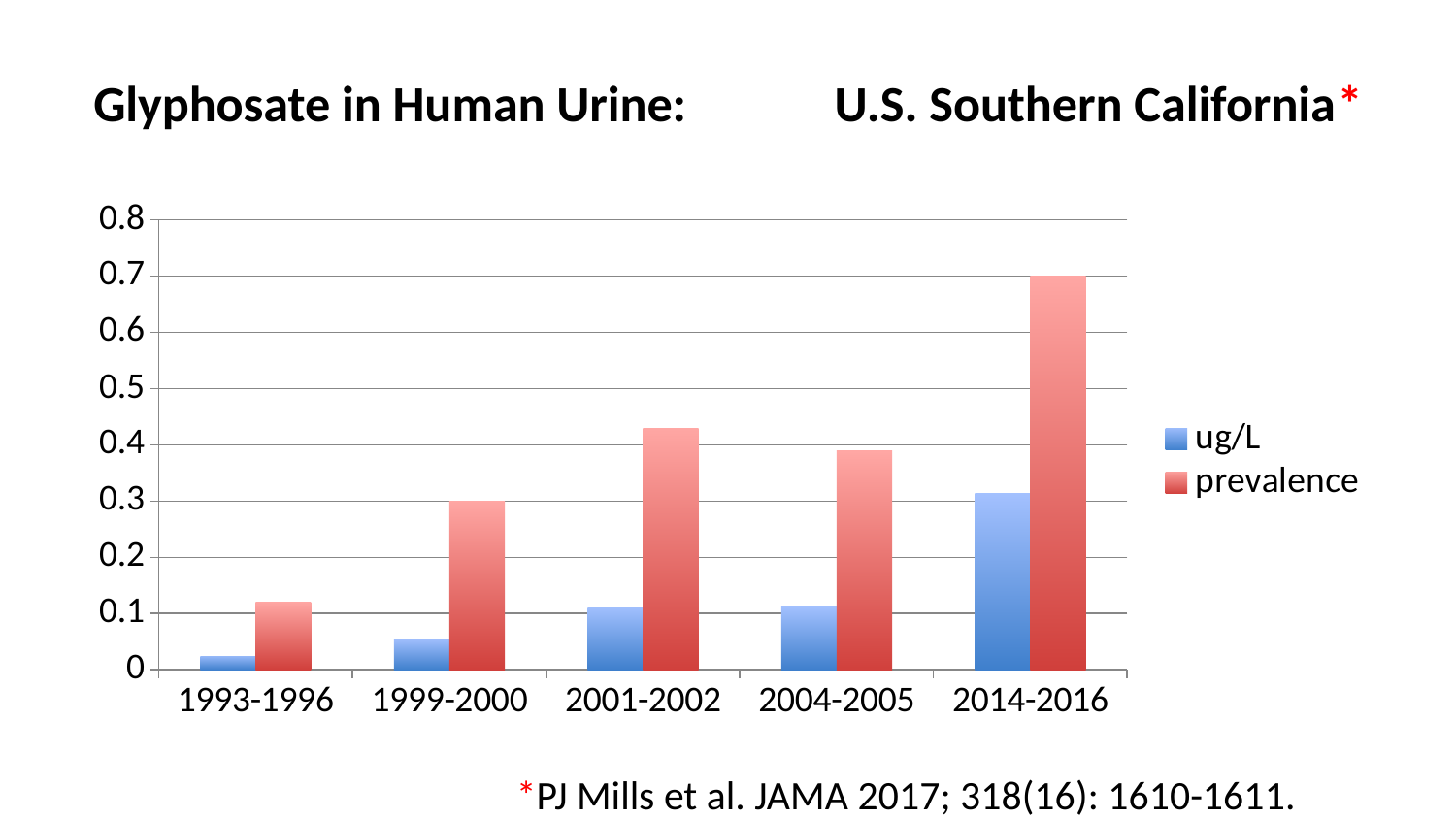
Is the ug/L value for 2014-2016 greater or less than 0.4? less What is the prevalence value for 2014-2016? 0.7 Which is larger: the prevalence value for 1993-1996 or the prevalence value for 1999-2000? 1999-2000 What is the prevalence value for 1999-2000? 0.3 What kind of chart is shown on the slide? bar chart How many time-period categories are shown on the x axis? 5 Is the prevalence value for 2001-2002 greater or less than 0.4? greater Do the ug/L values rise or fall from 1993-1996 to 2014-2016? rise How many series does the legend list? 2 What are the two entries listed in the legend? ug/L and prevalence Which period has the lowest ug/L value? 1993-1996 Which period has the highest prevalence value? 2014-2016